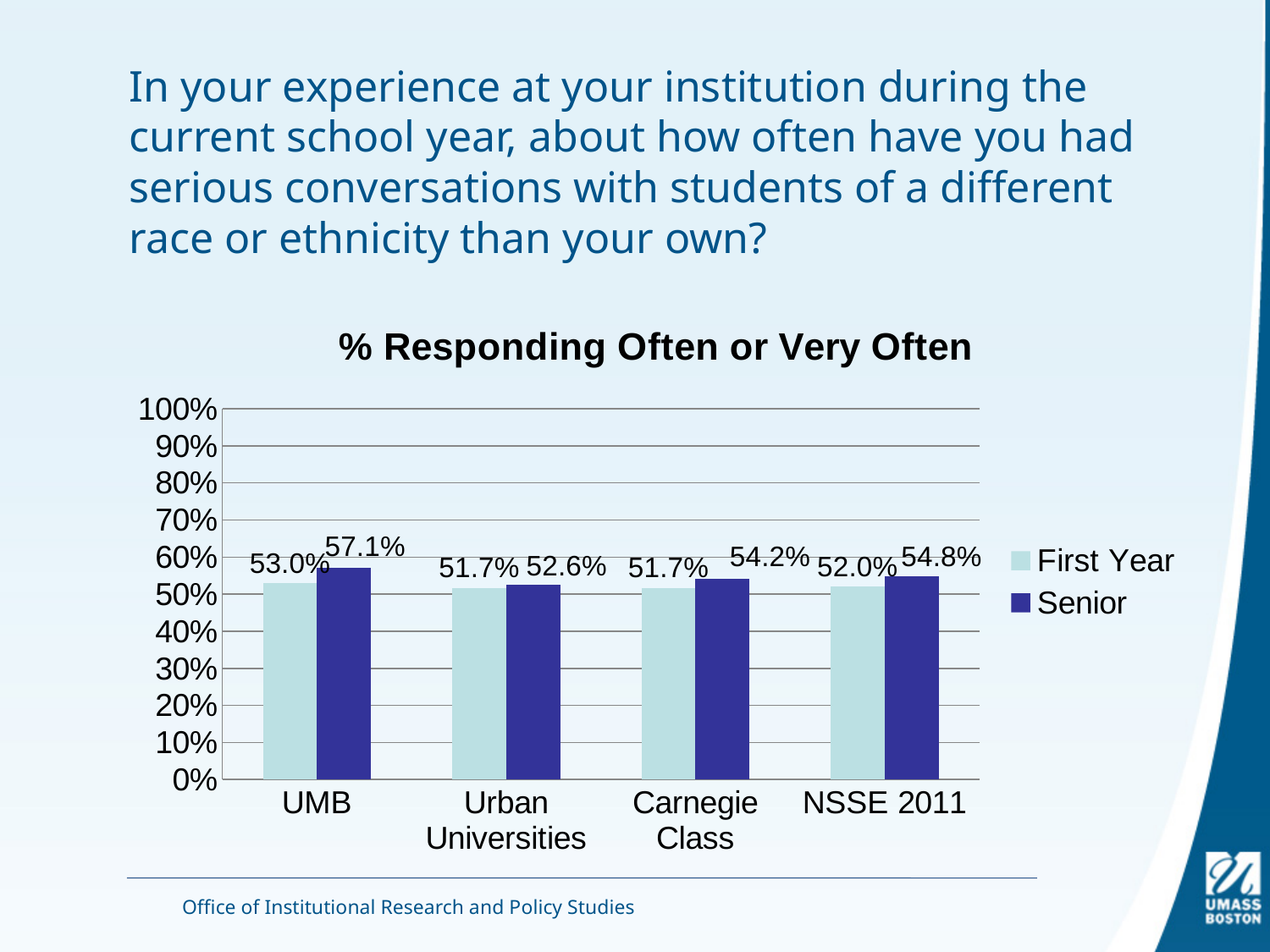
Which is larger for NSSE 2011, the First Year value or the Senior value? Senior What is the difference between the Senior and First Year values for UMB? 4.1% What is the First Year value for Urban Universities? 51.7% What is the Senior value for Carnegie Class? 54.2% How many categories are shown on the x axis? 4 What is the Senior value for NSSE 2011? 54.8% Which category has the highest Senior value? UMB How many series does the legend list? 2 Is the Senior value for UMB greater or less than 50%? greater What is the First Year value for UMB? 53.0% What kind of chart is shown on the slide? bar chart Which category has the lowest Senior value? Urban Universities